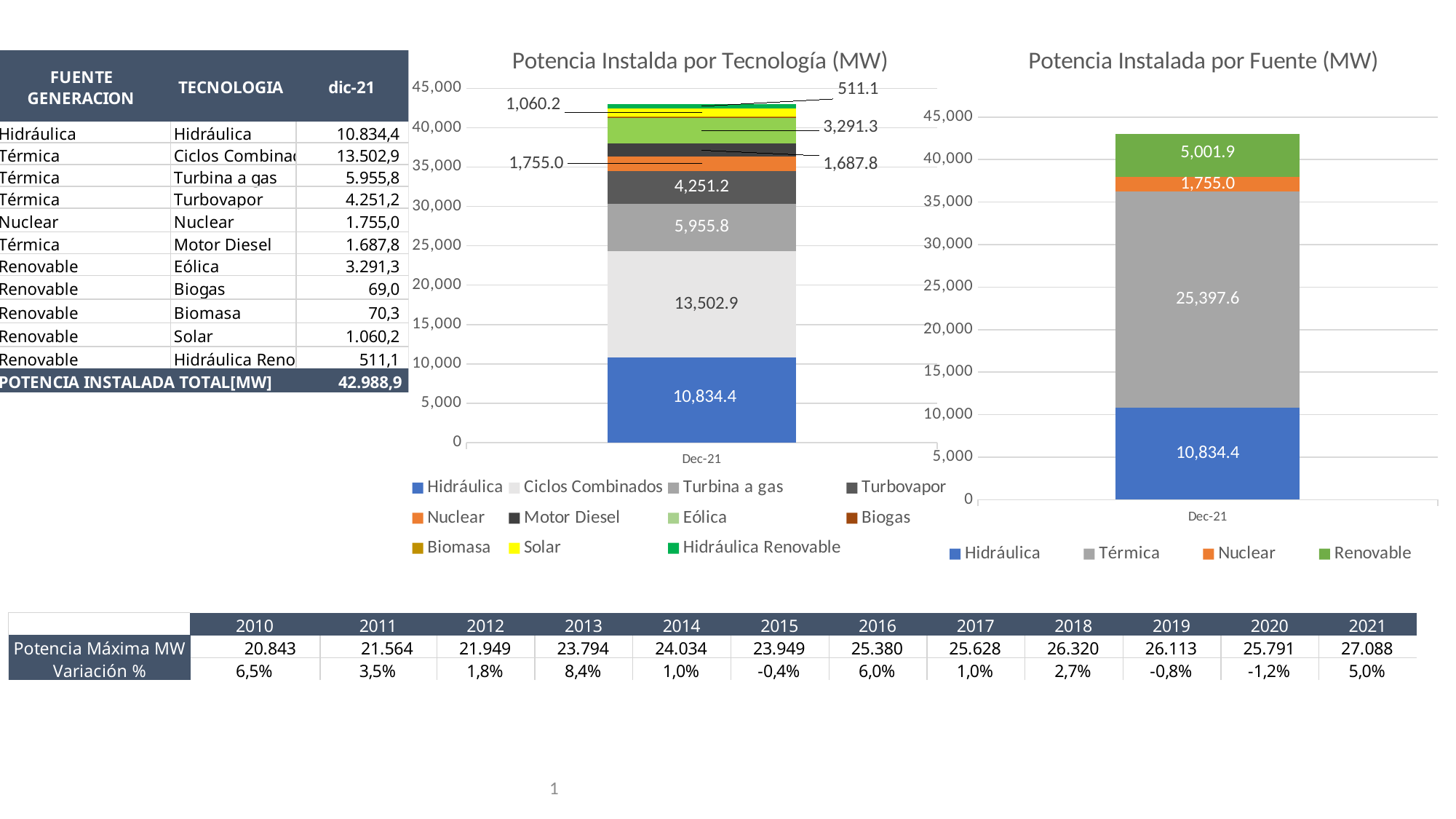
In the 'Potencia Instalada por Fuente (MW)' chart, which source has the smallest value? Nuclear In the 'Potencia Instalda por Tecnología (MW)' chart, which is larger, Turbina a gas or Turbovapor? Turbina a gas In the 'Potencia Instalada por Fuente (MW)' chart, which source has the largest value? Térmica In the 'Potencia Instalada por Fuente (MW)' chart, what is the value for Renovable? 5,001.9 In the 'Potencia Instalada por Fuente (MW)' chart, what is the total of the stacked bar for Dec-21? 42,988.9 In the 'Potencia Instalada por Fuente (MW)' chart, what is the value for Térmica? 25,397.6 What kind of chart is the 'Potencia Instalada por Fuente (MW)' chart? Stacked bar chart How many series does the legend of the 'Potencia Instalda por Tecnología (MW)' chart list? 11 In the 'Potencia Instalda por Tecnología (MW)' chart, what is the value for Eólica? 3,291.3 In the 'Potencia Instalda por Tecnología (MW)' chart, what is the value for Ciclos Combinados? 13,502.9 In the 'Potencia Instalada por Fuente (MW)' chart, what is the difference between Térmica and Hidráulica? 14,563.2 How many series does the legend of the 'Potencia Instalada por Fuente (MW)' chart list? 4